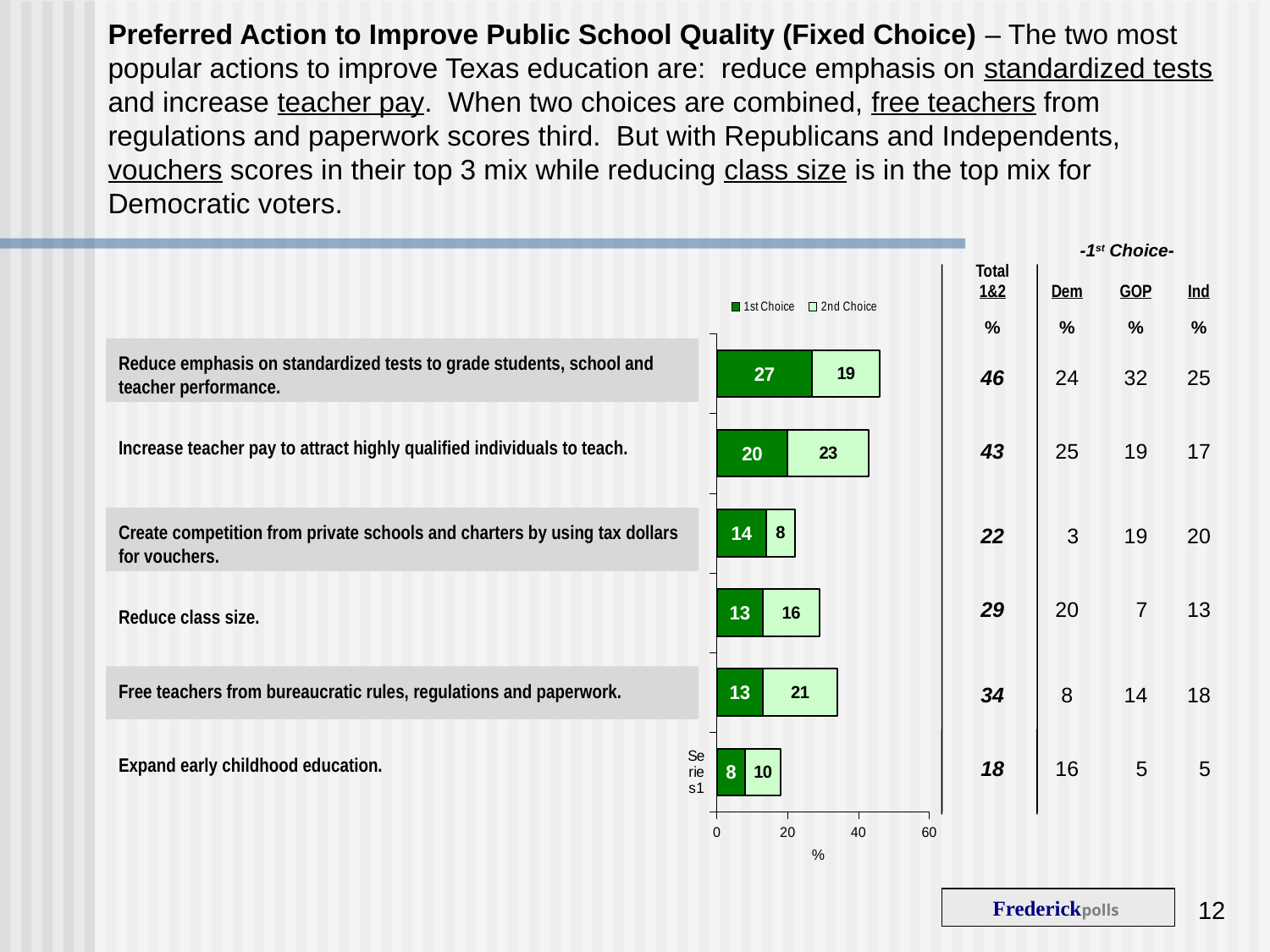
Which series is shown in dark green in the chart legend? 1st Choice Which is larger: the 2nd Choice value for "Increase teacher pay" or the 2nd Choice value for "Reduce emphasis on standardized tests"? Increase teacher pay What kind of chart is shown on the slide? stacked bar chart How many series does the chart legend list? 2 Which category has the highest 1st Choice value? Reduce emphasis on standardized tests to grade students, school and teacher performance. What is the total of the stacked bar for "Free teachers from bureaucratic rules, regulations and paperwork"? 34 What is the difference between the 1st Choice and 2nd Choice values for "Reduce class size"? 3 What is the 1st Choice value for "Reduce emphasis on standardized tests to grade students, school and teacher performance"? 27 Which category has the lowest 2nd Choice value? Create competition from private schools and charters by using tax dollars for vouchers. What is the 2nd Choice value for "Increase teacher pay to attract highly qualified individuals to teach"? 23 How many bars (categories) are plotted in the chart? 6 What is the 1st Choice value for "Expand early childhood education"? 8